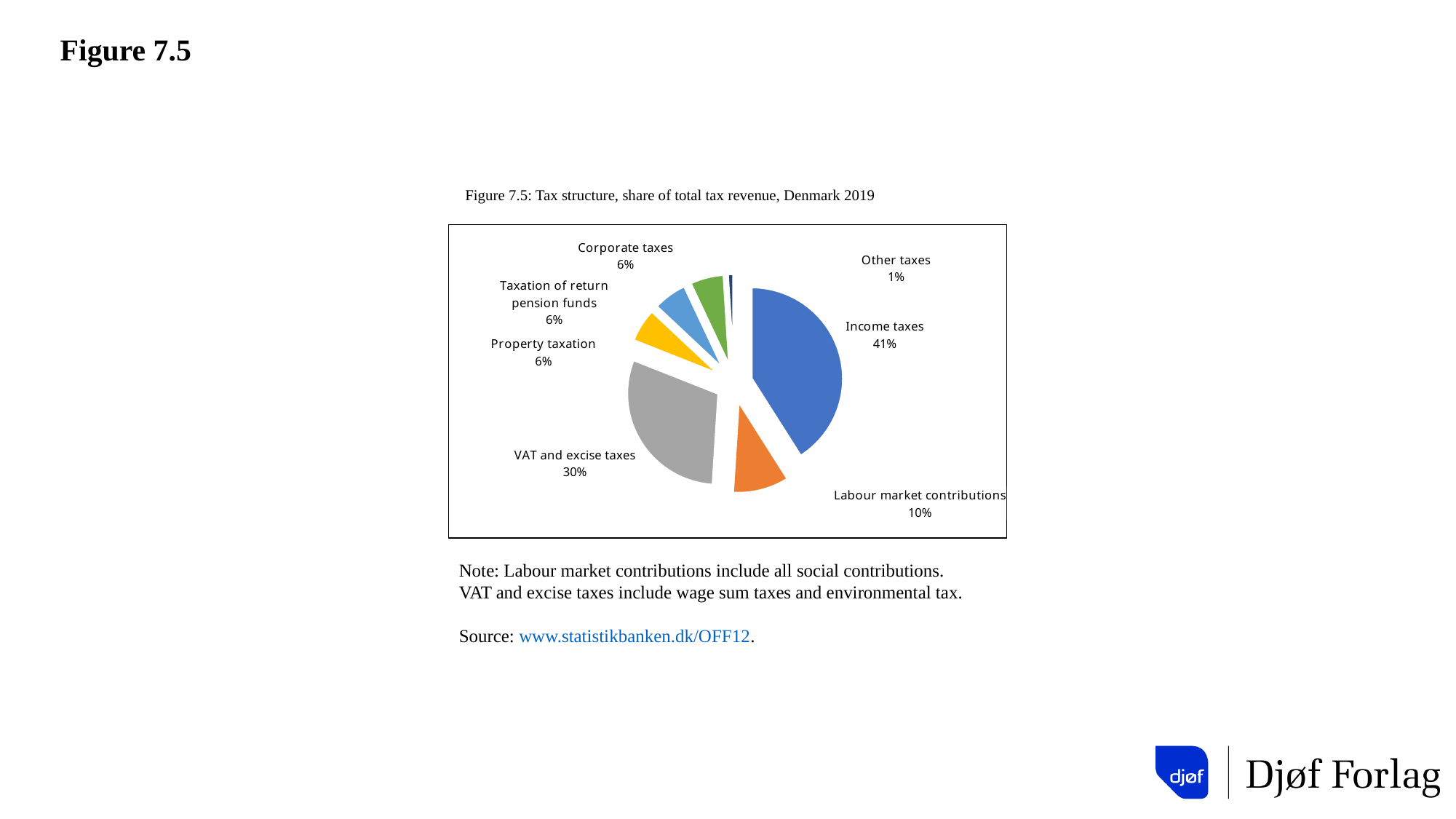
What share of total tax revenue comes from VAT and excise taxes? 30% What type of chart is shown on the slide? Pie chart What share of total tax revenue comes from Labour market contributions? 10% What is the difference in share between Income taxes and VAT and excise taxes? 11 percentage points How many categories are shown in the pie chart? 7 Which is larger: the share for Labour market contributions or the share for Corporate taxes? Labour market contributions What share of total tax revenue comes from Income taxes? 41% What share of total tax revenue comes from Other taxes? 1% What colour is the slice for VAT and excise taxes? Grey What is the title of the chart? Figure 7.5: Tax structure, share of total tax revenue, Denmark 2019 Which category has the largest share of total tax revenue? Income taxes Which category has the smallest share of total tax revenue? Other taxes